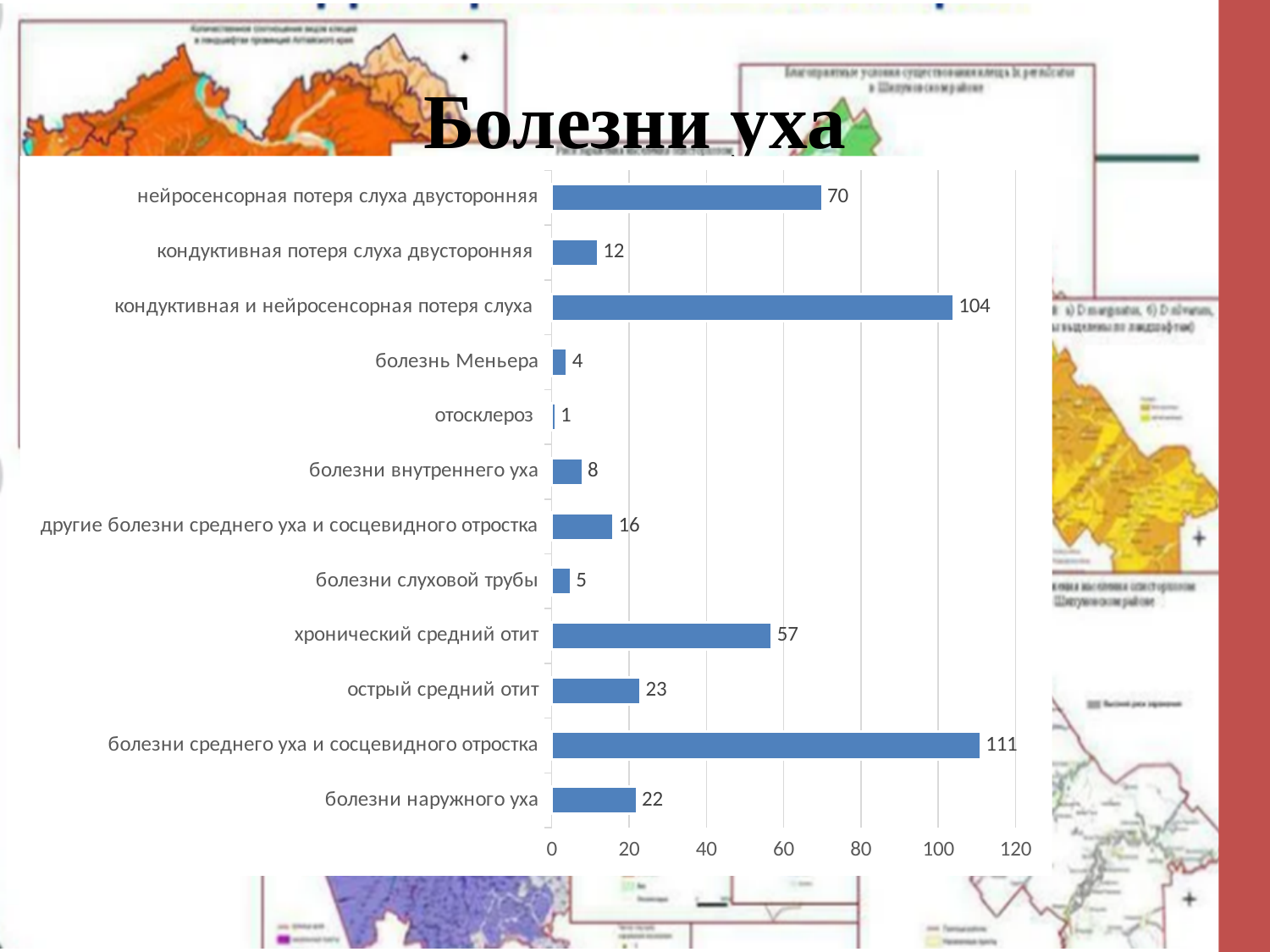
What is the value for 'болезни наружного уха'? 22 What is the value for 'хронический средний отит'? 57 Which category has the lowest value? отосклероз Which category has the highest value? болезни среднего уха и сосцевидного отростка How many categories are shown in the chart? 12 Which is larger: the value for 'острый средний отит' or the value for 'другие болезни среднего уха и сосцевидного отростка'? острый средний отит What is the difference between the values for 'нейросенсорная потеря слуха двусторонняя' and 'хронический средний отит'? 13 What kind of chart is shown on the slide? bar chart What is the title of the chart? Болезни уха Is the value for 'нейросенсорная потеря слуха двусторонняя' greater or less than 60? greater What is the value for 'кондуктивная и нейросенсорная потеря слуха'? 104 What is the difference between the values for 'болезни среднего уха и сосцевидного отростка' and 'кондуктивная и нейросенсорная потеря слуха'? 7